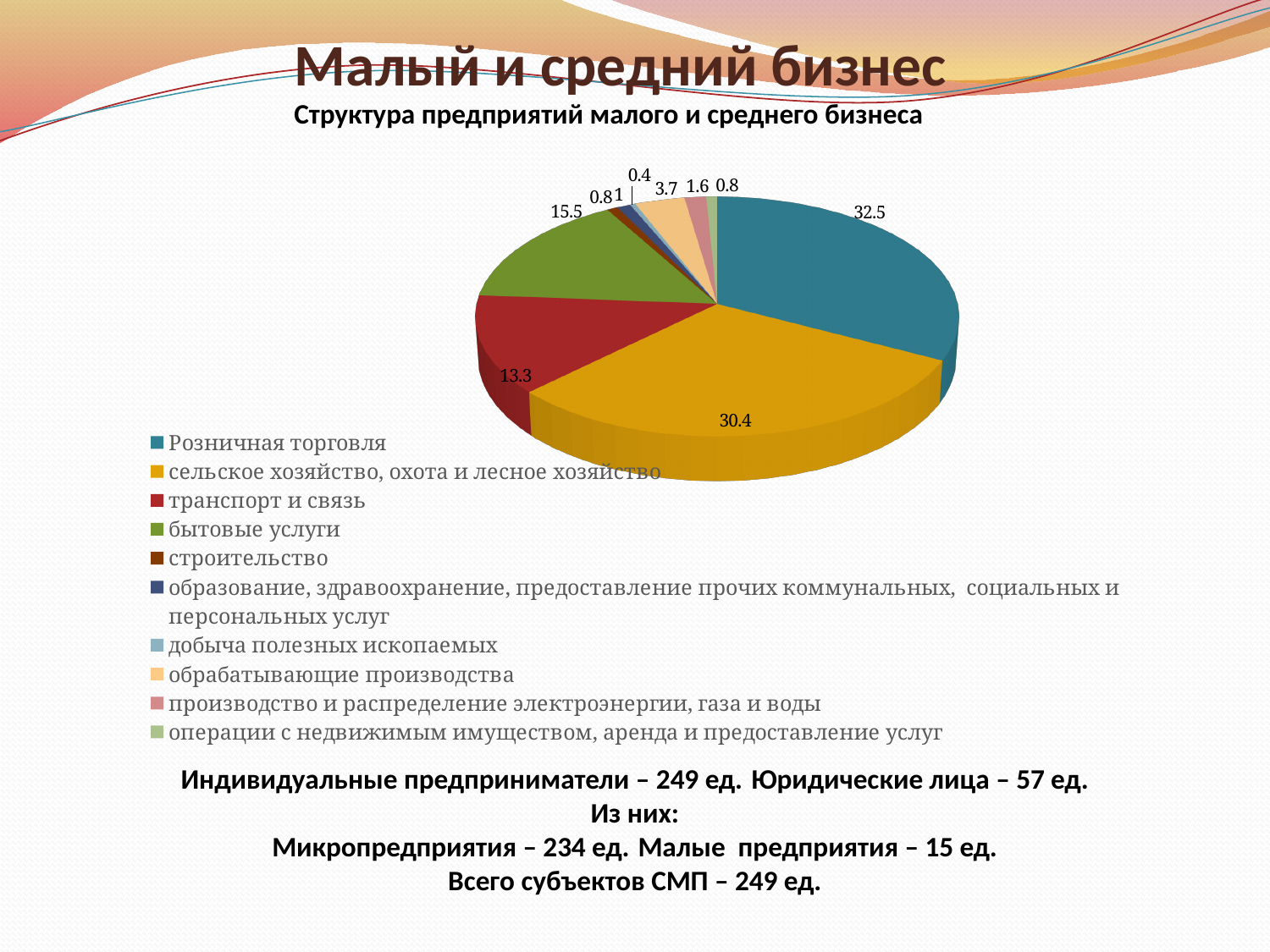
What type of chart is shown on the slide? pie chart Which is larger, бытовые услуги or транспорт и связь? бытовые услуги What is the value for сельское хозяйство, охота и лесное хозяйство? 30.4 What is the value for транспорт и связь? 13.3 How many categories does the legend list? 10 What is the value for обрабатывающие производства? 3.7 Which category has the smallest share of the pie? добыча полезных ископаемых What is the value for бытовые услуги? 15.5 What is the value for Розничная торговля? 32.5 What is the title of the chart? Структура предприятий малого и среднего бизнеса Which category has the largest share of the pie? Розничная торговля What is the difference between the values for Розничная торговля and сельское хозяйство, охота и лесное хозяйство? 2.1